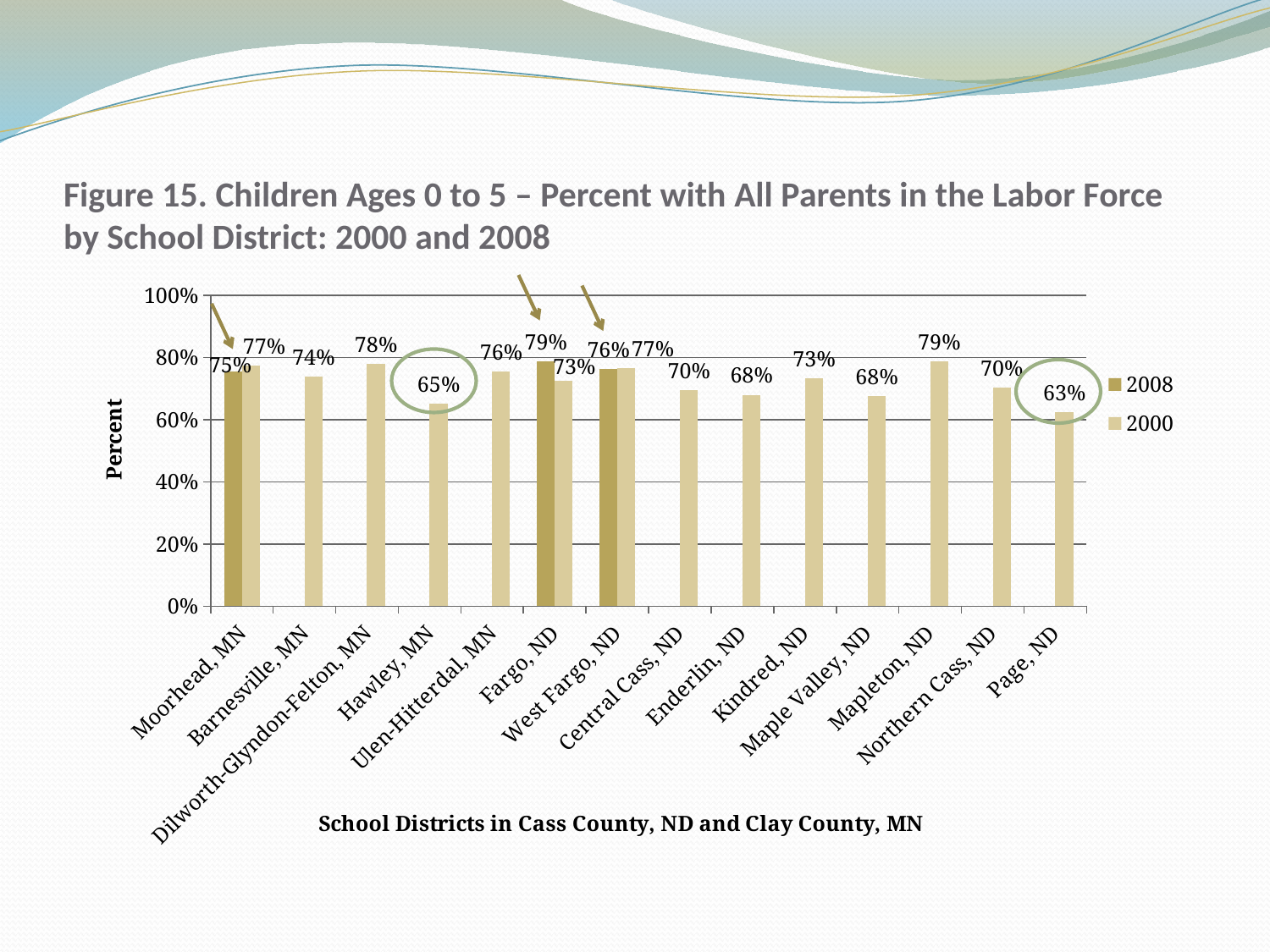
What kind of chart is shown on the slide? Bar chart What is the 2000 value for Page, ND? 63% How many school districts are shown on the x axis? 14 How many series does the legend list? 2 What is the difference between the 2008 and 2000 values for Fargo, ND? 6% What is the label of the x axis? School Districts in Cass County, ND and Clay County, MN For West Fargo, ND, which is larger: the 2008 value or the 2000 value? 2000 What is the 2008 value for Moorhead, MN? 75% Which school district has the lowest 2000 value? Page, ND What is the 2000 value for Hawley, MN? 65% What is the 2008 value for Fargo, ND? 79% Which school district has the highest 2000 value? Mapleton, ND